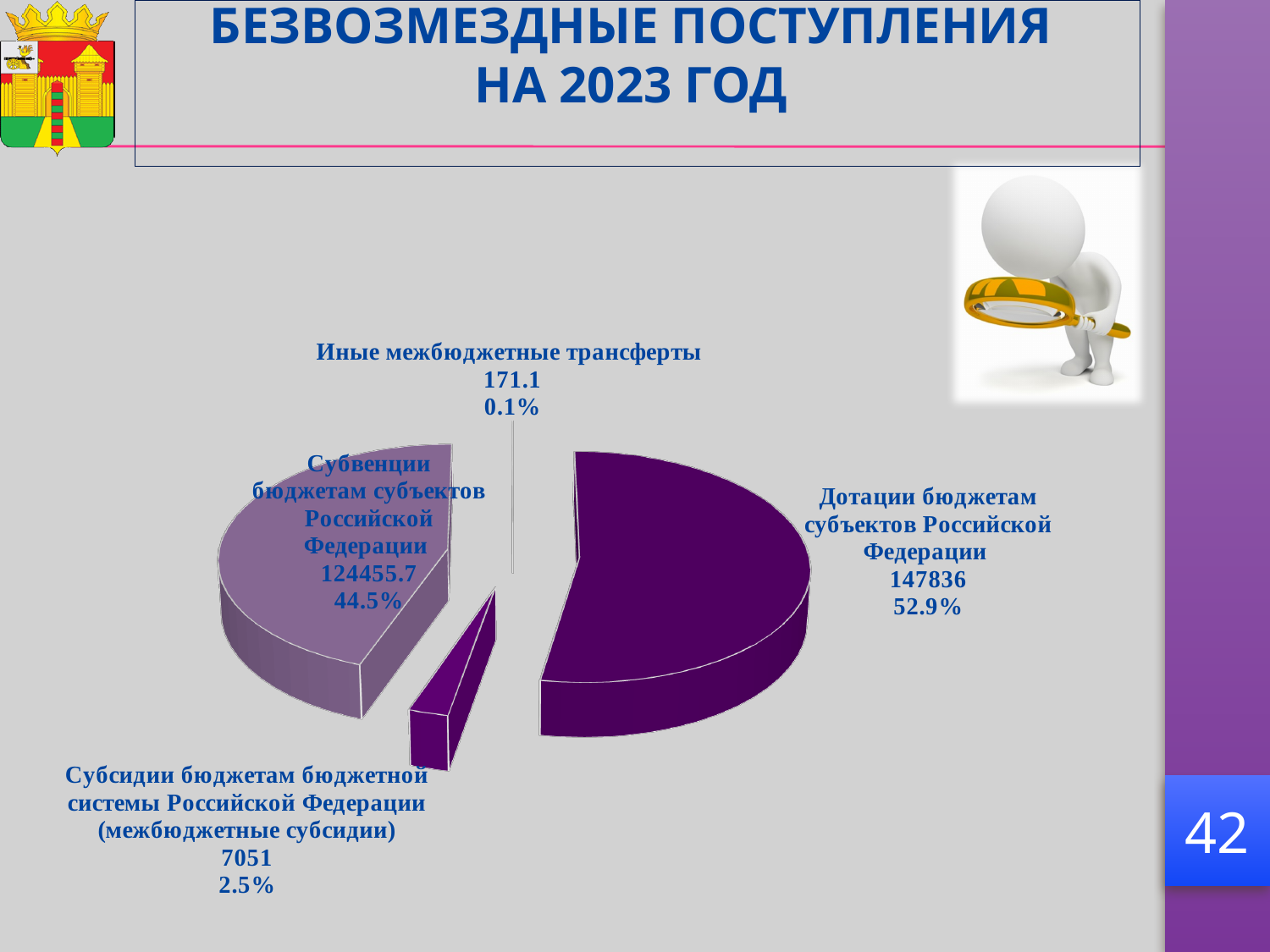
What is the value for Субсидии бюджетам бюджетной системы Российской Федерации (межбюджетные субсидии)? 7051 What share of the pie does Субвенции бюджетам субъектов Российской Федерации represent? 44.5% What is the difference between the values for Дотации бюджетам субъектов Российской Федерации and Субвенции бюджетам субъектов Российской Федерации? 23380.3 What share of the pie does Субсидии бюджетам бюджетной системы Российской Федерации (межбюджетные субсидии) represent? 2.5% How many slices does the pie chart have? 4 What is the value for Иные межбюджетные трансферты? 171.1 What is the title of the slide containing the chart? БЕЗВОЗМЕЗДНЫЕ ПОСТУПЛЕНИЯ НА 2023 ГОД What is the value for Дотации бюджетам субъектов Российской Федерации? 147836 What is the value for Субвенции бюджетам субъектов Российской Федерации? 124455.7 What kind of chart is shown on the slide? pie chart Which category has the smallest share of the pie? Иные межбюджетные трансферты Which category has the largest share of the pie? Дотации бюджетам субъектов Российской Федерации